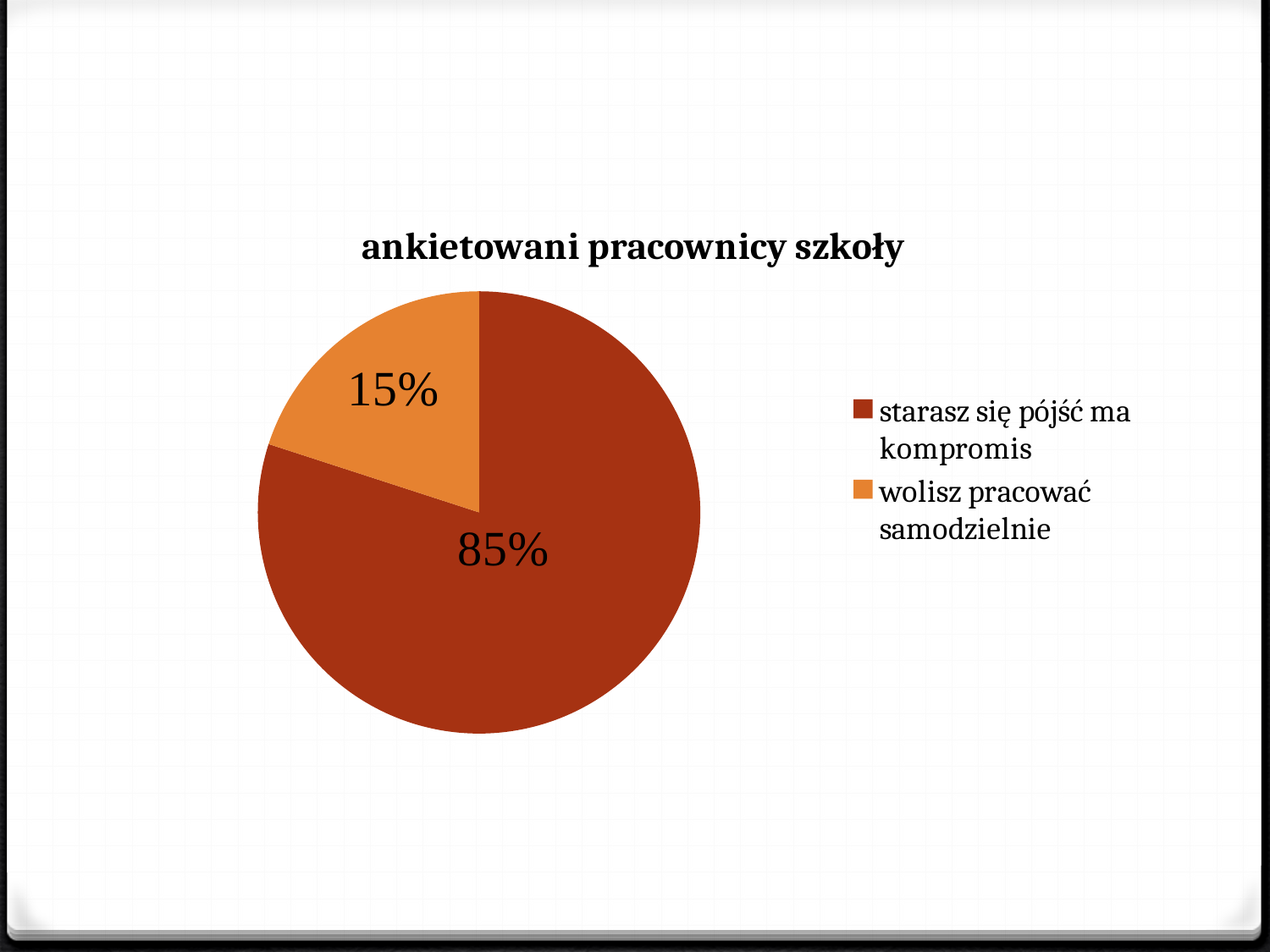
What percentage is shown for "wolisz pracować samodzielnie"? 15% What colour is the slice for "wolisz pracować samodzielnie"? orange How many slices does the pie chart have? 2 What is the difference in percentage points between "starasz się pójść ma kompromis" and "wolisz pracować samodzielnie"? 70 Which category has the smallest share of the pie? wolisz pracować samodzielnie What percentage is shown for "starasz się pójść ma kompromis"? 85% Which is larger: the share for "starasz się pójść ma kompromis" or for "wolisz pracować samodzielnie"? starasz się pójść ma kompromis Which category has the largest share of the pie? starasz się pójść ma kompromis What share of the pie does the "wolisz pracować samodzielnie" slice represent? 15% What kind of chart is shown on the slide? pie chart How many entries does the legend list? 2 What is the title of the chart? ankietowani pracownicy szkoły